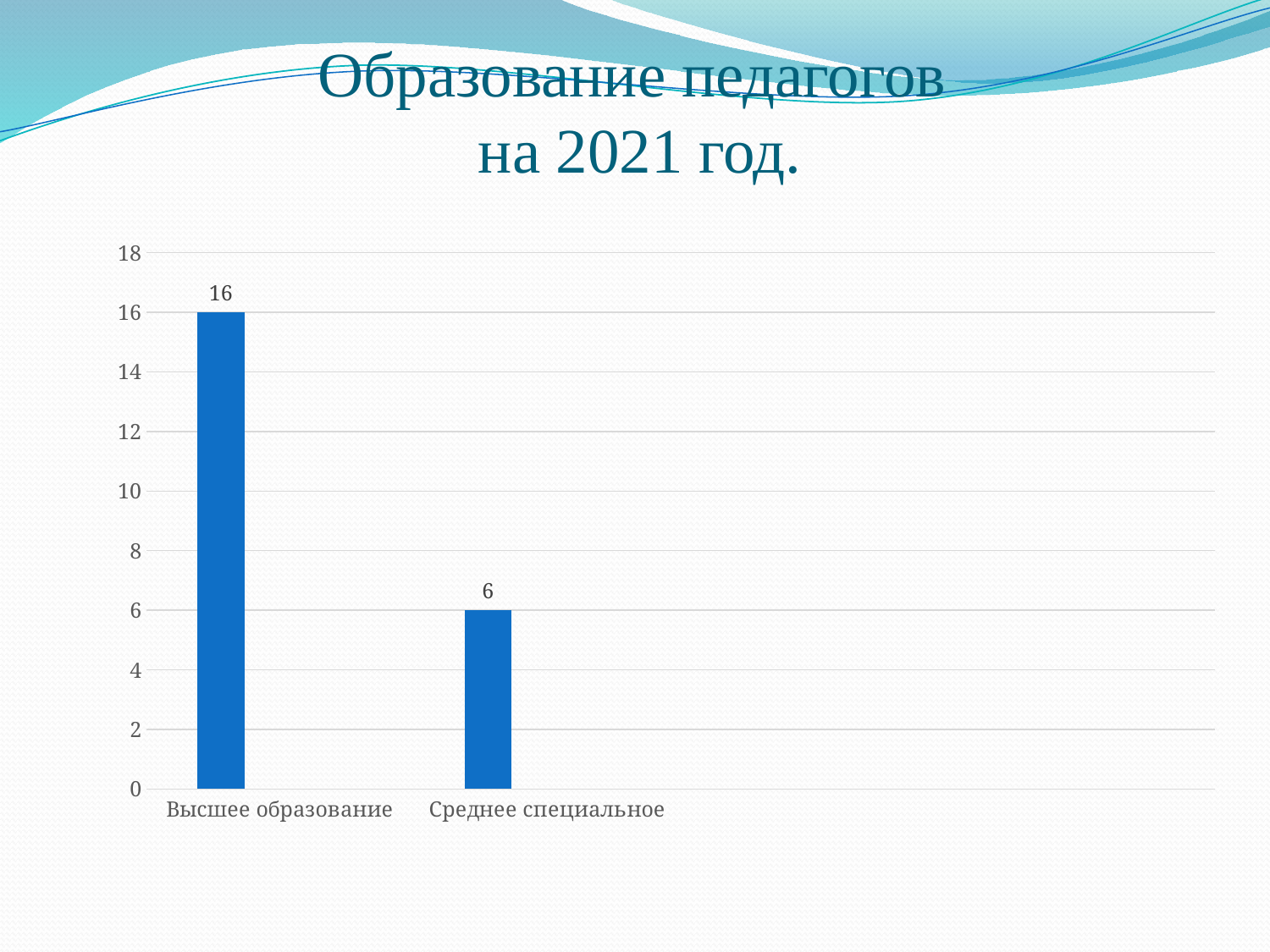
What kind of chart is shown on the slide? bar chart Is the value for Среднее специальное greater or less than 10? less What is the value for Среднее специальное? 6 What is the title of the slide? Образование педагогов на 2021 год. Is the value for Высшее образование greater or less than 14? greater What is the total of the two values shown on the chart? 22 Which category has the highest value? Высшее образование Which category has the lowest value? Среднее специальное What is the difference between the values for Высшее образование and Среднее специальное? 10 Which is larger, the value for Высшее образование or the value for Среднее специальное? Высшее образование How many categories are shown on the chart? 2 What is the value for Высшее образование? 16